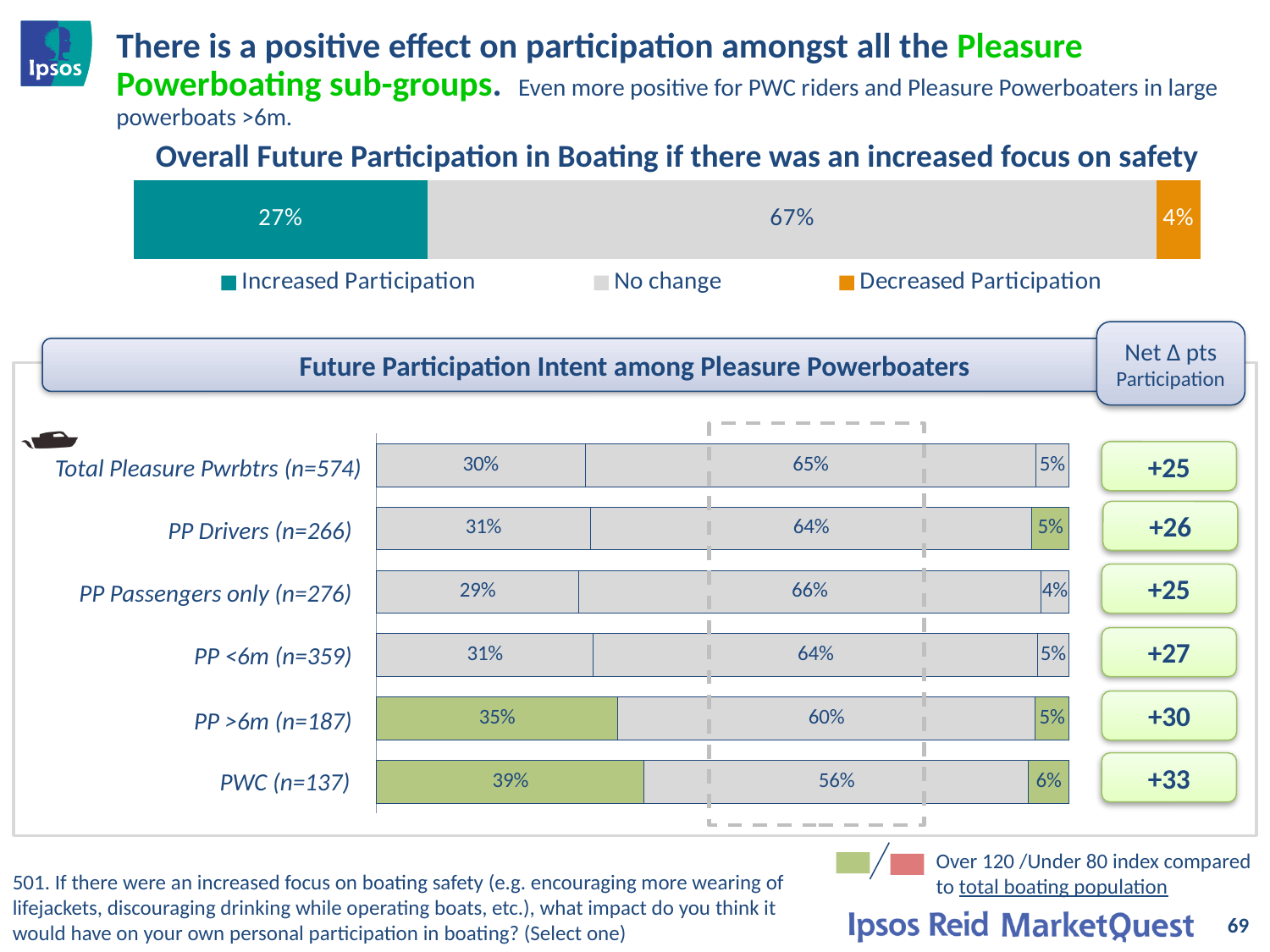
In the 'Overall Future Participation in Boating if there was an increased focus on safety' chart, what percentage is shown for Increased Participation? 27% In the 'Overall Future Participation in Boating if there was an increased focus on safety' chart, what percentage is shown for No change? 67% What kind of chart is the 'Future Participation Intent among Pleasure Powerboaters' chart? Stacked horizontal bar chart In the 'Future Participation Intent among Pleasure Powerboaters' chart, what is the increased participation percentage for PWC (n=137)? 39% In the 'Future Participation Intent among Pleasure Powerboaters' chart, what is the no change percentage for PP >6m (n=187)? 60% In the 'Future Participation Intent among Pleasure Powerboaters' chart, which group has the lowest increased participation percentage? PP Passengers only (n=276) In the 'Future Participation Intent among Pleasure Powerboaters' chart, which has a larger increased participation percentage: PP >6m (n=187) or PP Drivers (n=266)? PP >6m (n=187) In the 'Future Participation Intent among Pleasure Powerboaters' chart, what is the Net Δ pts Participation value for PP <6m (n=359)? +27 In the 'Future Participation Intent among Pleasure Powerboaters' chart, how many groups are plotted? 6 In the 'Overall Future Participation in Boating if there was an increased focus on safety' chart, how many series does the legend list? 3 In the 'Future Participation Intent among Pleasure Powerboaters' chart, which group has the highest increased participation percentage? PWC (n=137) In the 'Overall Future Participation in Boating if there was an increased focus on safety' chart, what is the difference between the No change and Increased Participation percentages? 40 percentage points